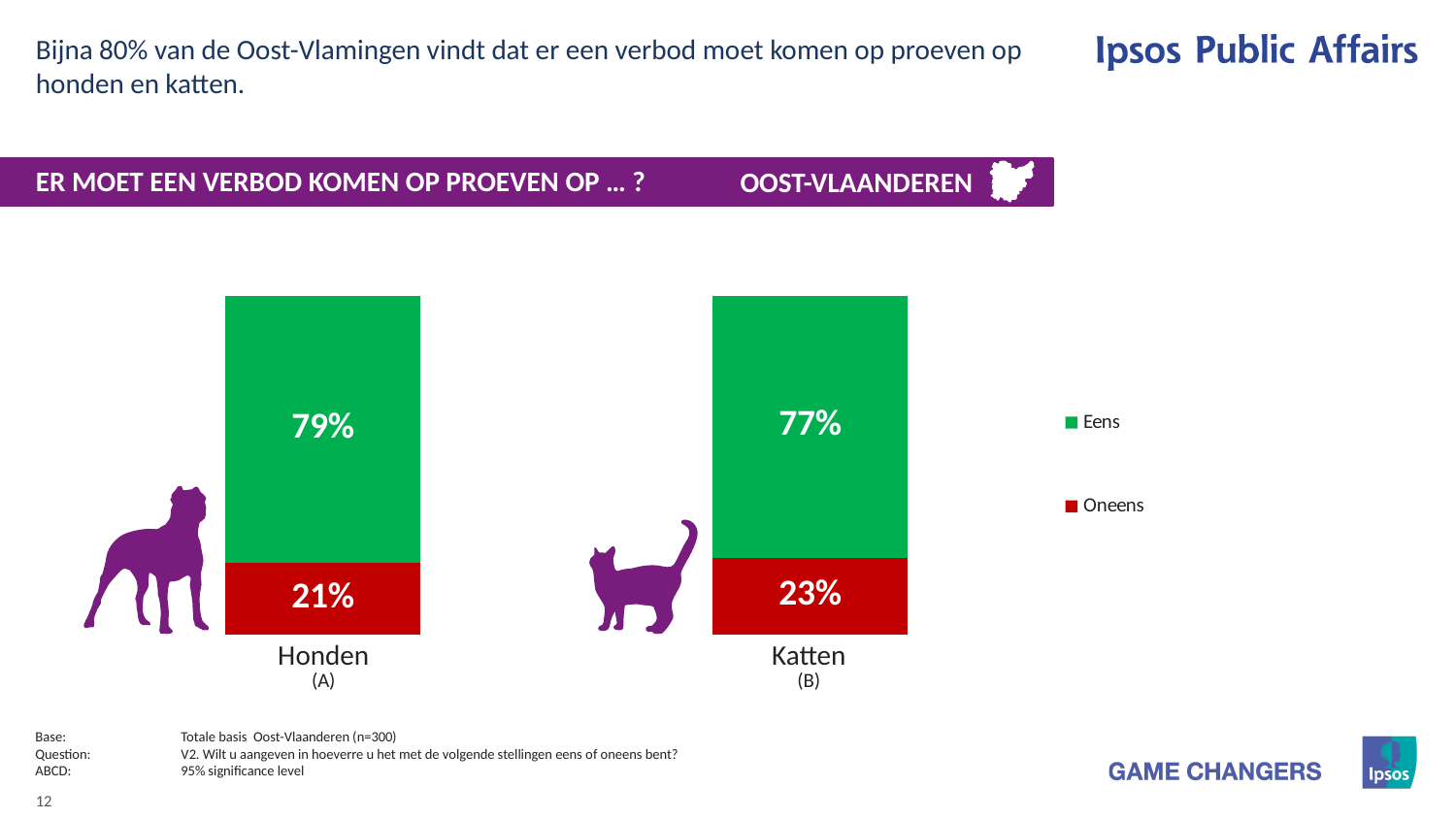
Which category has the lowest Oneens share? Honden What kind of chart is shown on the slide? Stacked bar chart What is the total of the stacked bar for Katten? 100% Which category has the higher Eens share, Honden or Katten? Honden What is the difference between the Eens values for Honden and Katten? 2% What percentage of respondents disagree (Oneens) with a ban on testing on cats (Katten)? 23% How many series does the legend list? 2 Which colour represents Oneens in the legend? Red What is the Oneens value for Honden? 21% What is the Eens value for Katten? 77% How many categories are shown on the x axis? 2 What percentage of respondents agree (Eens) with a ban on testing on dogs (Honden)? 79%